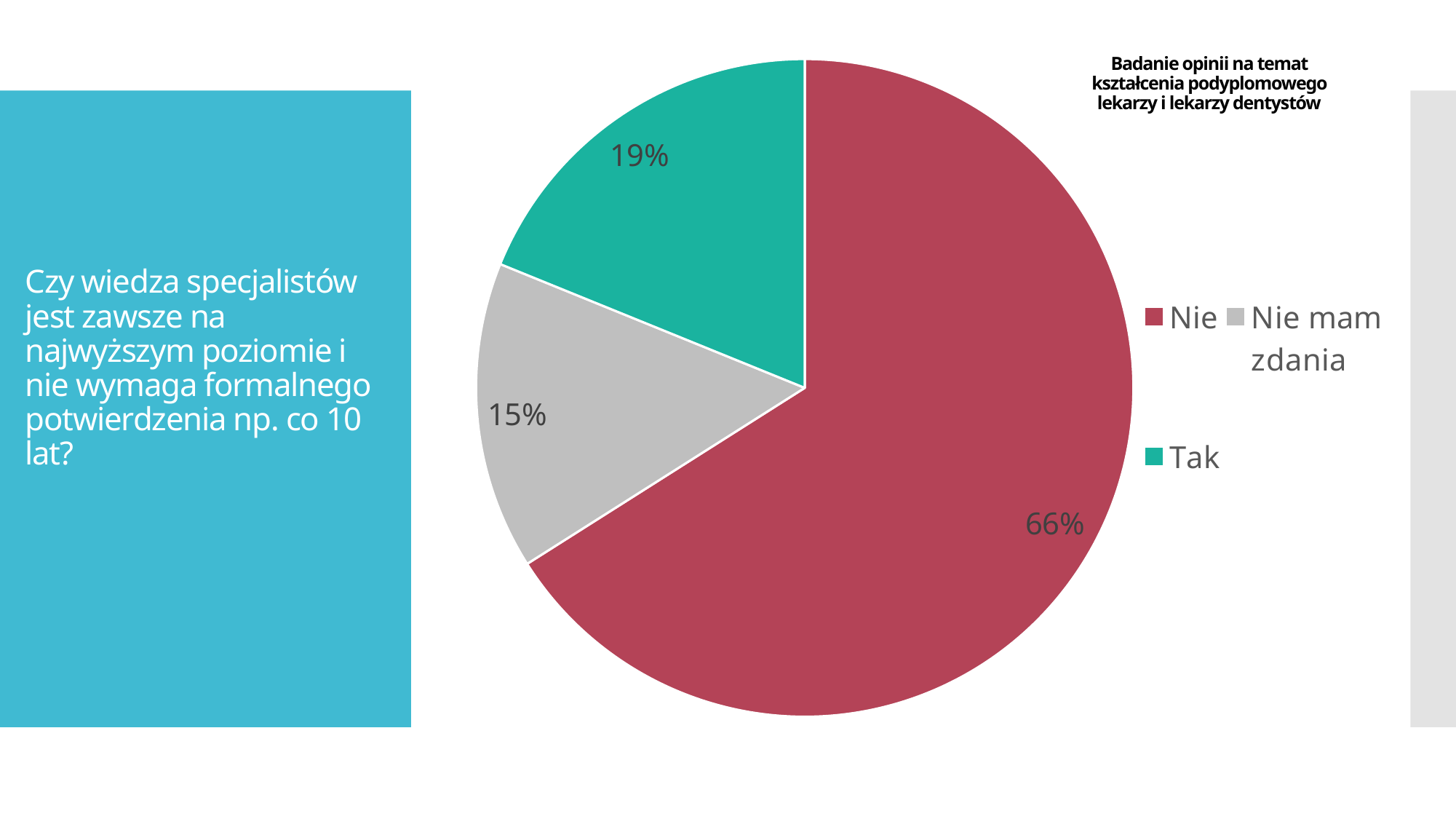
What is the difference in percentage points between the "Tak" slice and the "Nie mam zdania" slice? 4 What share of the pie does the "Nie mam zdania" slice represent? 15% How many entries does the legend list? 3 Which is larger, the "Tak" slice or the "Nie mam zdania" slice? Tak Which category has the largest slice of the pie? Nie How many slices does the pie chart have? 3 What share of the pie does the "Tak" slice represent? 19% Which category has the smallest slice of the pie? Nie mam zdania What colour is the "Tak" slice in the pie chart? teal (green) What kind of chart is shown on the slide? pie chart What is the difference in percentage points between the "Nie" slice and the "Tak" slice? 47 What share of the pie does the "Nie" slice represent? 66%